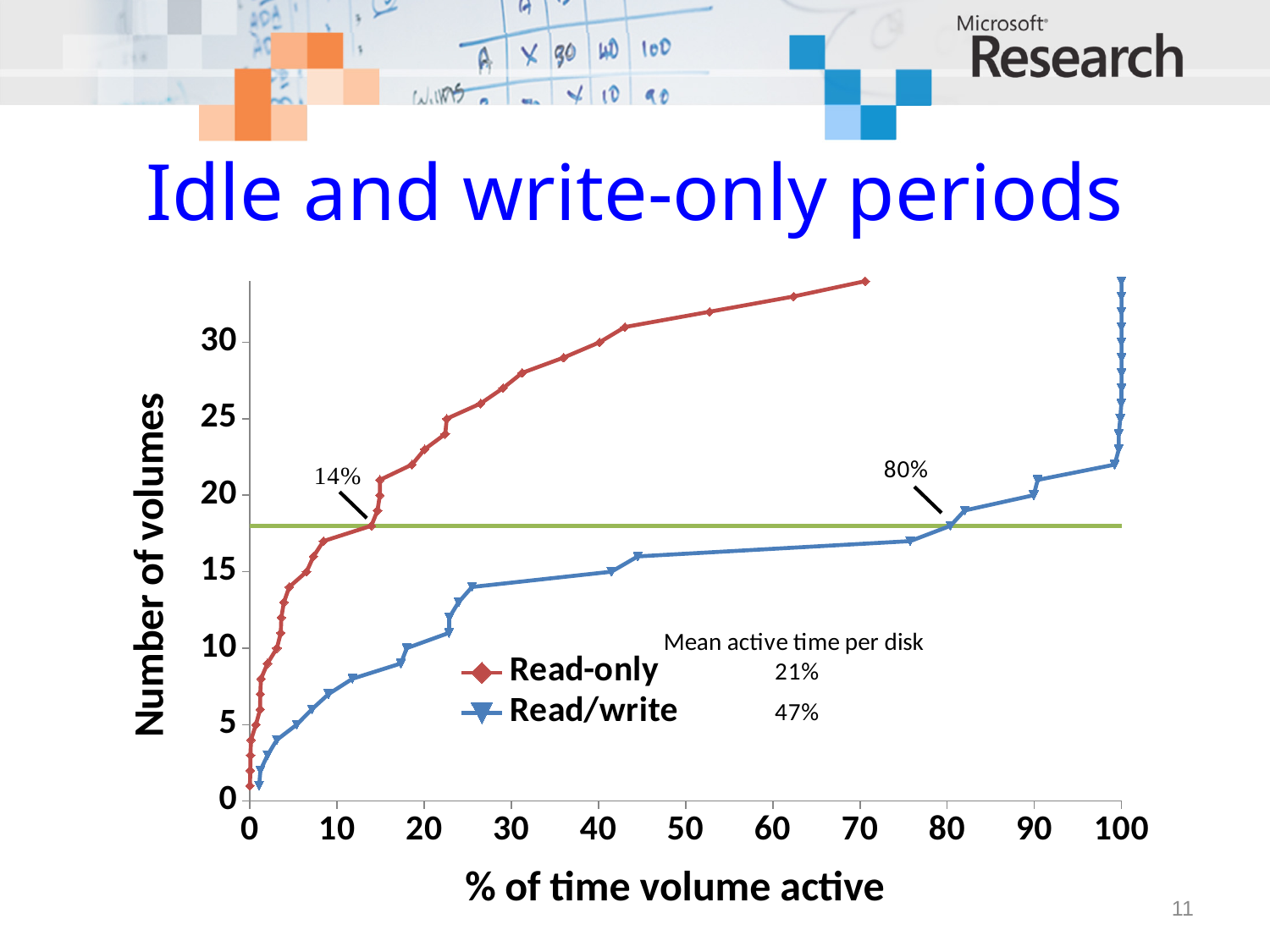
What kind of chart is shown on the slide? line chart At what % of time volume active does the Read-only curve cross the green horizontal line, according to the annotation? 14% Which series has the higher mean active time per disk, Read-only or Read/write? Read/write What is the mean active time per disk for the Read/write series? 47% What is the mean active time per disk for the Read-only series? 21% How many series does the legend list? 2 Do the number of volumes for both series rise or fall as % of time volume active increases? rise What is the difference between the mean active time per disk of the Read/write series and the Read-only series? 26 percentage points Is the number of volumes for the Read/write series at 50% of time volume active greater or less than 20? less What are the two series named in the legend? Read-only and Read/write What is the label of the x axis? % of time volume active At what % of time volume active does the Read/write curve cross the green horizontal line, according to the annotation? 80%